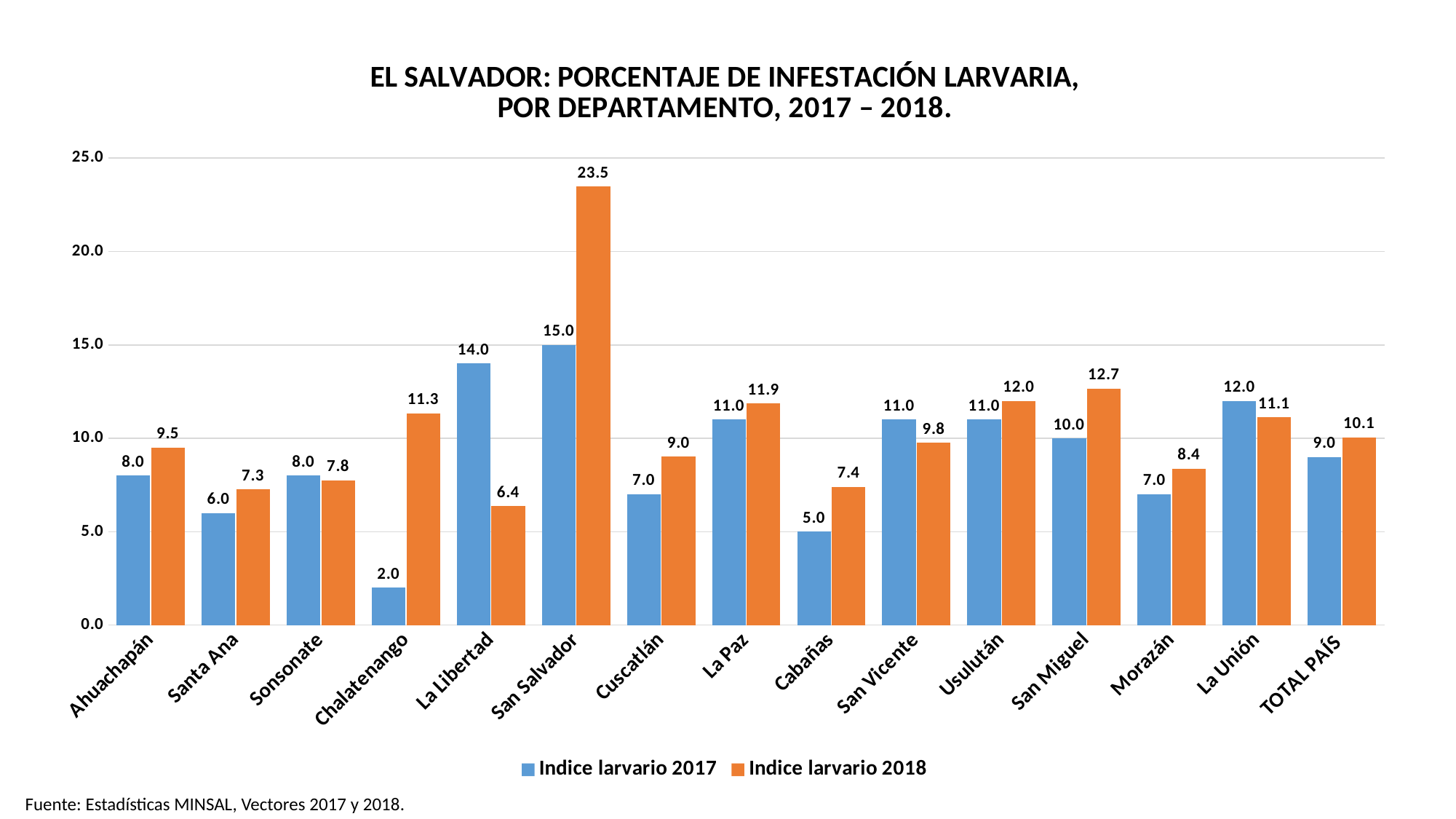
Which category has the lowest Indice larvario 2017 value? Chalatenango What kind of chart is shown on the slide? bar chart What is the Indice larvario 2017 value for Chalatenango? 2.0 How many categories are shown on the x axis? 15 How many series does the legend list? 2 Which department has the highest Indice larvario 2018 value? San Salvador Is the Indice larvario 2018 value for San Salvador greater or less than 20.0? greater What is the Indice larvario 2018 value for San Salvador? 23.5 What is the difference between the Indice larvario 2018 and Indice larvario 2017 values for San Salvador? 8.5 Which is larger for La Libertad: the Indice larvario 2017 value or the Indice larvario 2018 value? Indice larvario 2017 What colour represents the Indice larvario 2018 series? orange What is the Indice larvario 2018 value for TOTAL PAÍS? 10.1